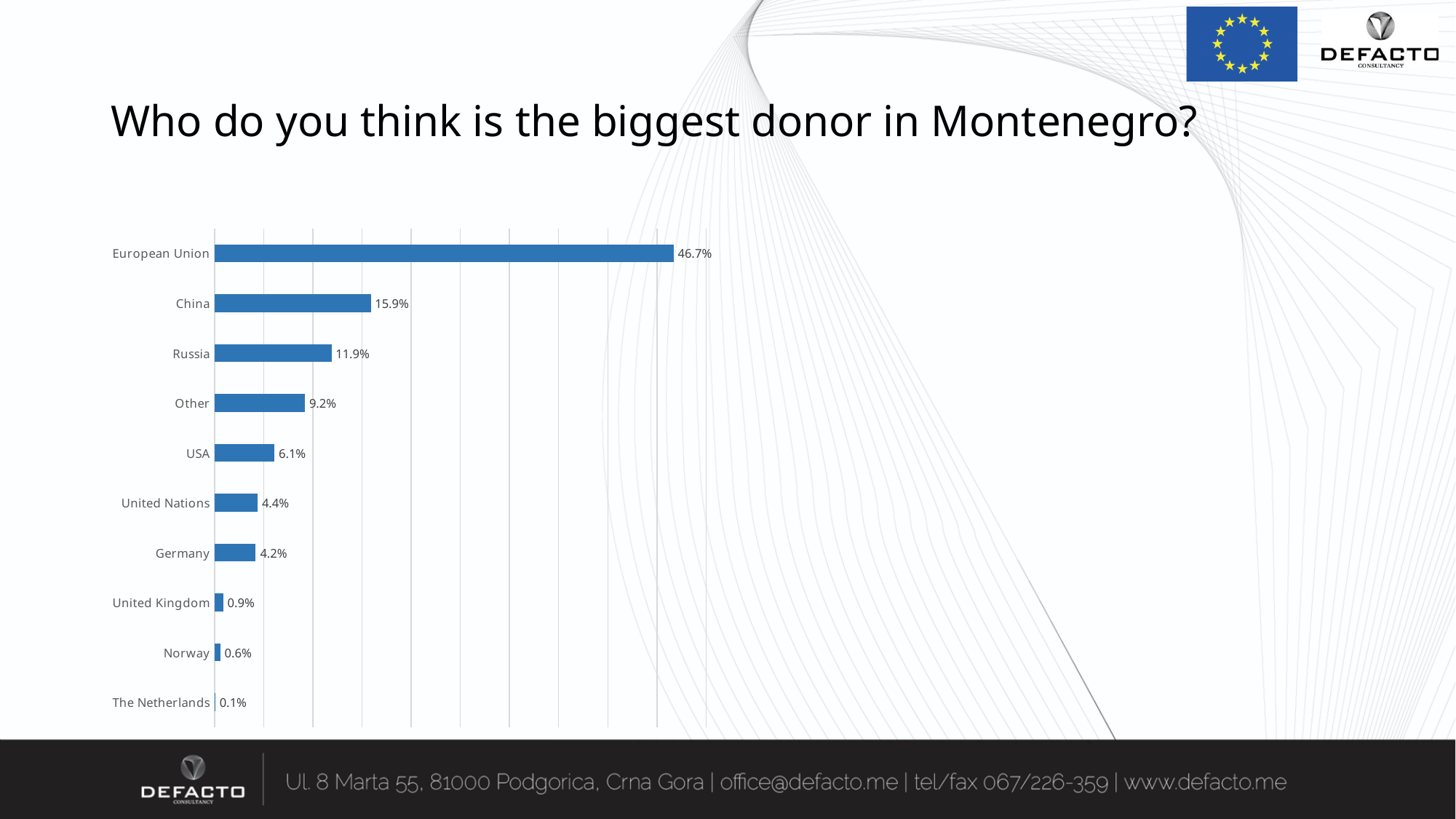
What percentage of respondents named the European Union as the biggest donor in Montenegro? 46.7% What is the difference between the values for the European Union and China? 30.8% Which category has the highest value in the chart? European Union Which category has the lowest value in the chart? The Netherlands What is the value shown for The Netherlands? 0.1% What kind of chart is shown on the slide? Bar chart Which has a larger value, Russia or Other? Russia How many categories are shown in the chart? 10 What is the difference between the values for the USA and Germany? 1.9% What is the value shown for the United Nations? 4.4% What is the value shown for China? 15.9% What is the value shown for Russia? 11.9%